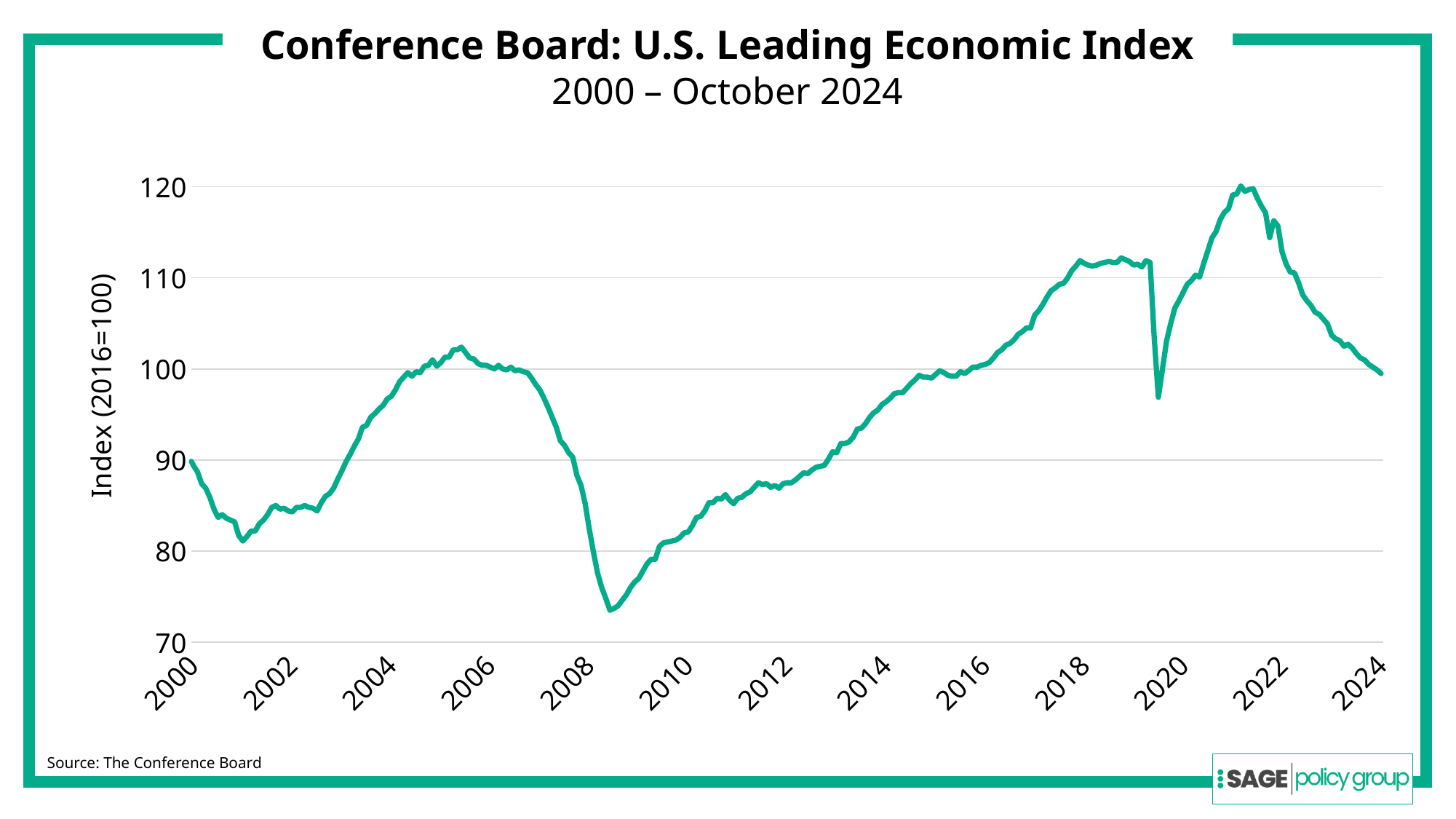
Is the lowest value of the index around 2009 greater or less than 80? less What is the highest value shown on the vertical axis? 120 Does the index rise or fall between 2009 and 2018? rise What kind of chart is shown on the slide? line chart Is the value of the index at the end of the series in 2024 greater or less than 110? less How many year labels are shown on the horizontal axis? 13 Is the value of the index at the start of 2000 greater or less than 80? greater What is the title of the chart? Conference Board: U.S. Leading Economic Index What is the label on the vertical axis? Index (2016=100) Does the index rise or fall between 2022 and 2024? fall